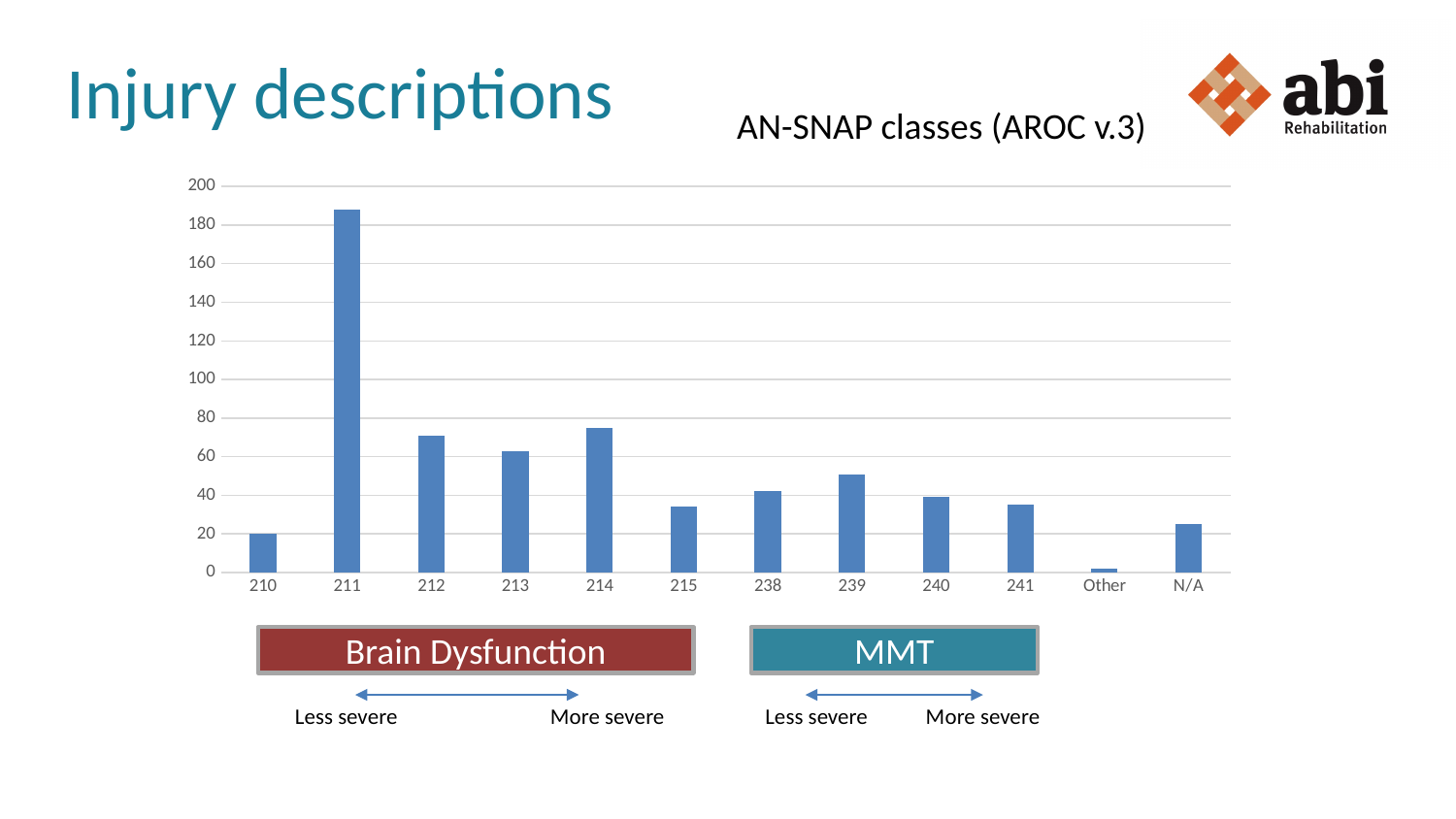
How many categories are shown on the x axis of the chart? 12 Is the value for class 239 greater or less than 40? greater Is the value for class 211 greater or less than 180? greater What is the title of the chart? AN-SNAP classes (AROC v.3) Which group label is shown beneath classes 238 to 241? MMT Is the value for class 214 greater or less than 80? less What kind of chart is shown on the slide? bar chart Which category has the lowest bar? Other Which has the larger value, class 239 or class 240? 239 Which AN-SNAP class has the highest bar? 211 Which has the larger value, class 213 or class 214? 214